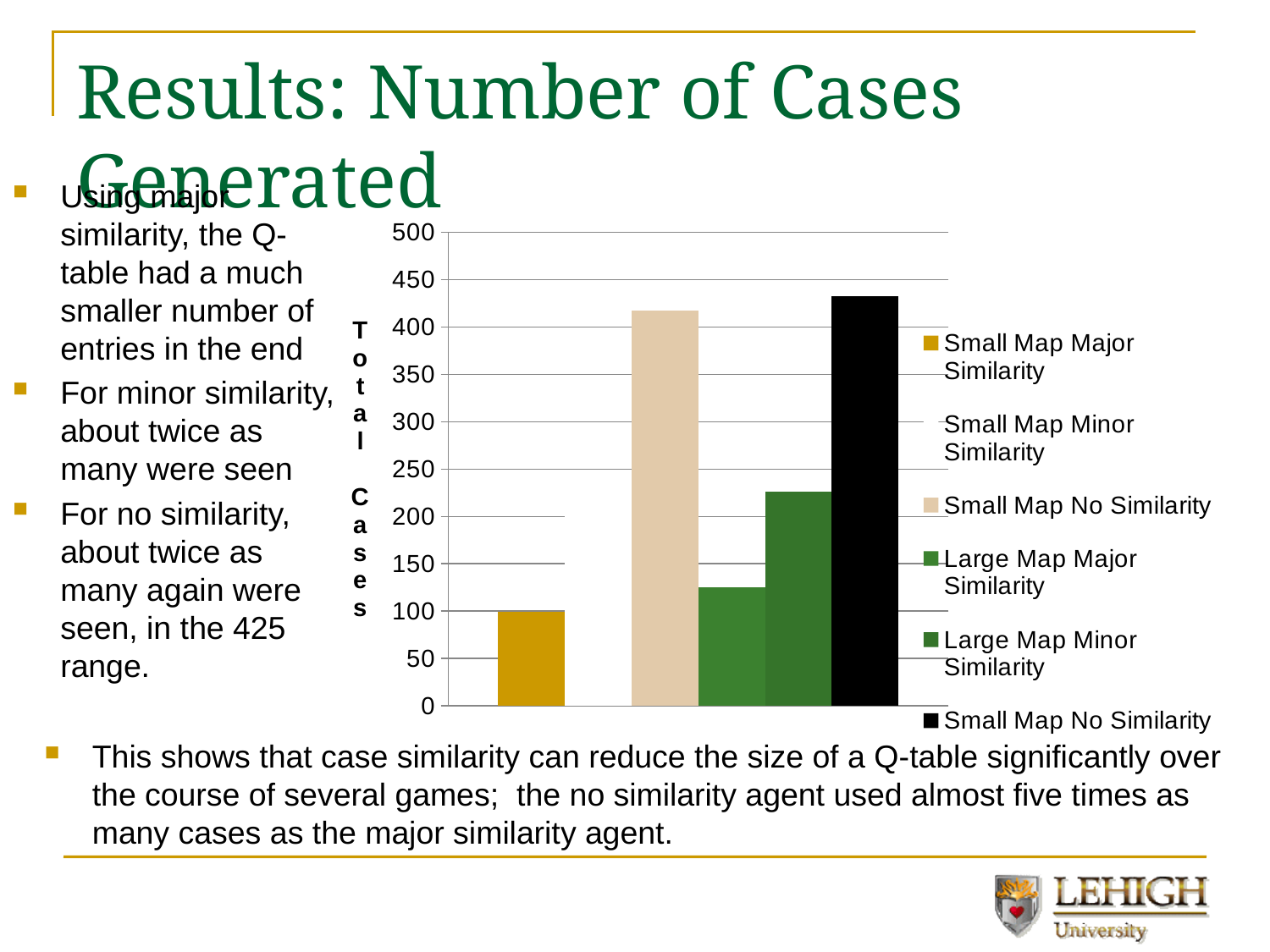
What kind of chart is shown on the slide? bar chart Is the value for Large Map Minor Similarity greater or less than 200? greater Which is larger, Small Map Major Similarity or Large Map Minor Similarity? Large Map Minor Similarity What is the highest value shown on the chart's vertical axis? 500 Is the value for Small Map Major Similarity greater or less than 150? less What is the label on the chart's vertical axis? Total Cases How many series does the chart's legend list? 6 Is the value for Small Map No Similarity (the tan bar) greater or less than 400? greater Which is larger, Large Map Minor Similarity or Large Map Major Similarity? Large Map Minor Similarity